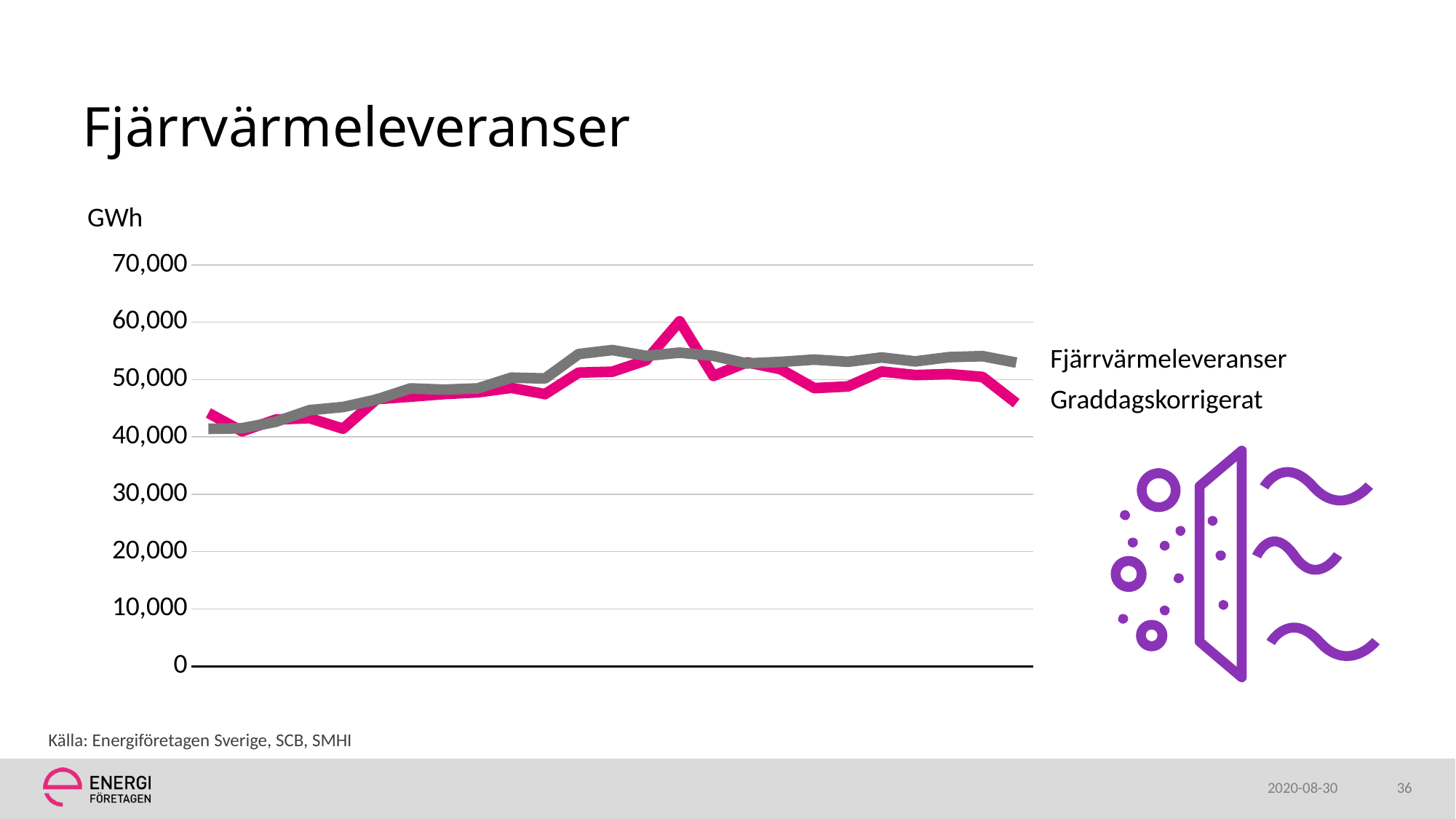
Is the last value of the Fjärrvärmeleveranser series greater or less than 50,000? less What unit is shown on the y axis of the chart? GWh Which series is drawn in pink, Fjärrvärmeleveranser or Graddagskorrigerat? Fjärrvärmeleveranser At the right-hand end of the chart, which series is higher, Fjärrvärmeleveranser or Graddagskorrigerat? Graddagskorrigerat How many series does the chart show? 2 What kind of chart is shown on the slide? line chart What is the title of the chart on the slide? Fjärrvärmeleveranser Is the highest value of the Graddagskorrigerat series greater or less than 60,000? less At its highest peak, is the Fjärrvärmeleveranser series greater or less than 50,000? greater Which series reaches the highest single value on the chart? Fjärrvärmeleveranser Does the Graddagskorrigerat series overall rise or fall from the left to the right of the chart? rise